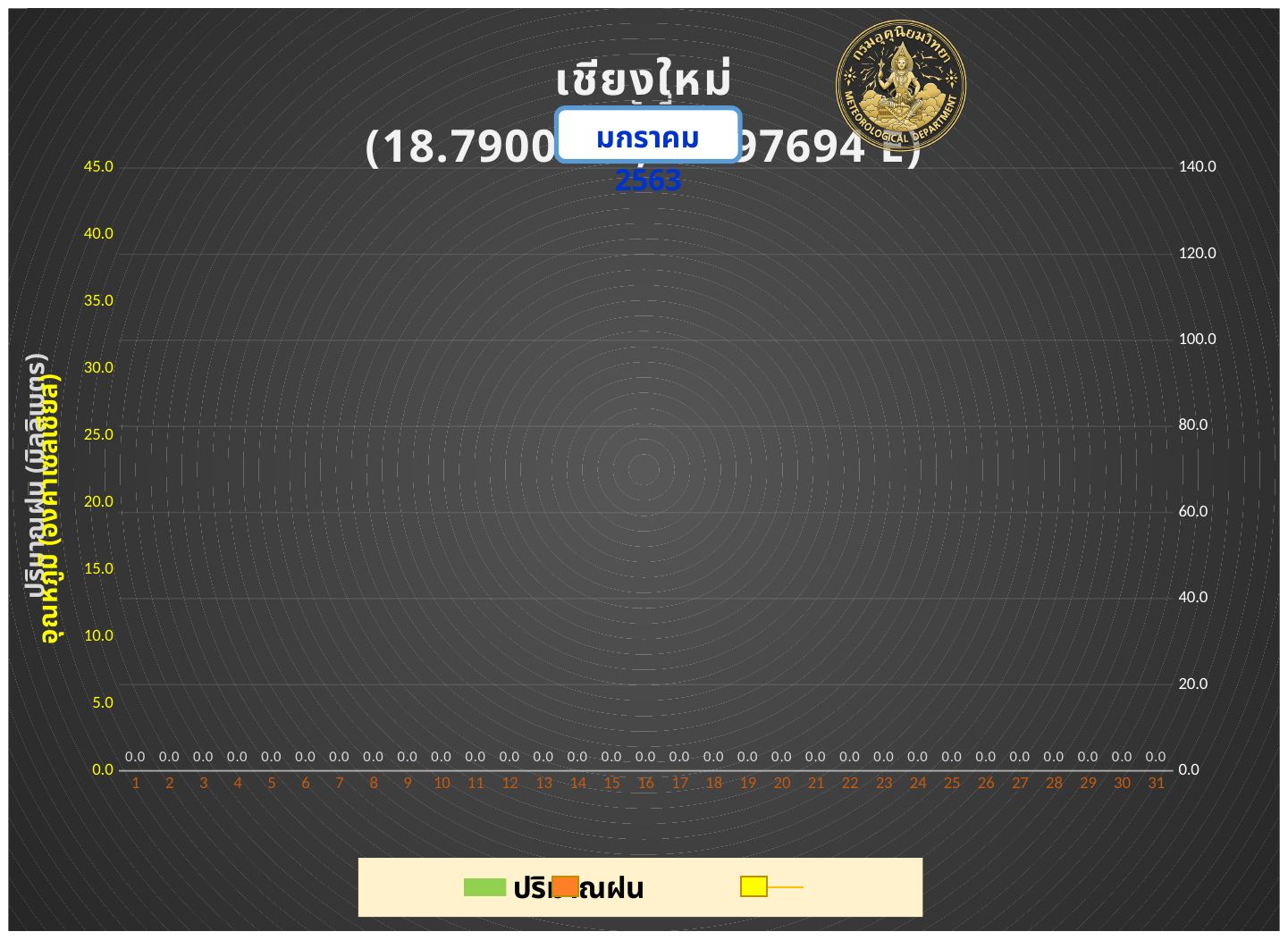
Is the value for day 10 greater or less than 5.0 on the left axis? less How many days are listed along the x axis of the chart? 31 What is the difference between the values for day 3 and day 20? 0.0 What is the highest tick value shown on the left vertical axis? 45.0 Do the plotted values rise, fall, or stay the same from day 1 to day 31? stay the same What is the data label shown for day 1 on the chart? 0.0 What is the data label shown for day 31 on the chart? 0.0 What is the last x-axis label on the chart? 31 Is the value for day 25 greater or less than 20.0 on the right axis? less What is the highest tick value shown on the right vertical axis? 140.0 What is the data label shown for day 15 on the chart? 0.0 What is the first x-axis label on the chart? 1